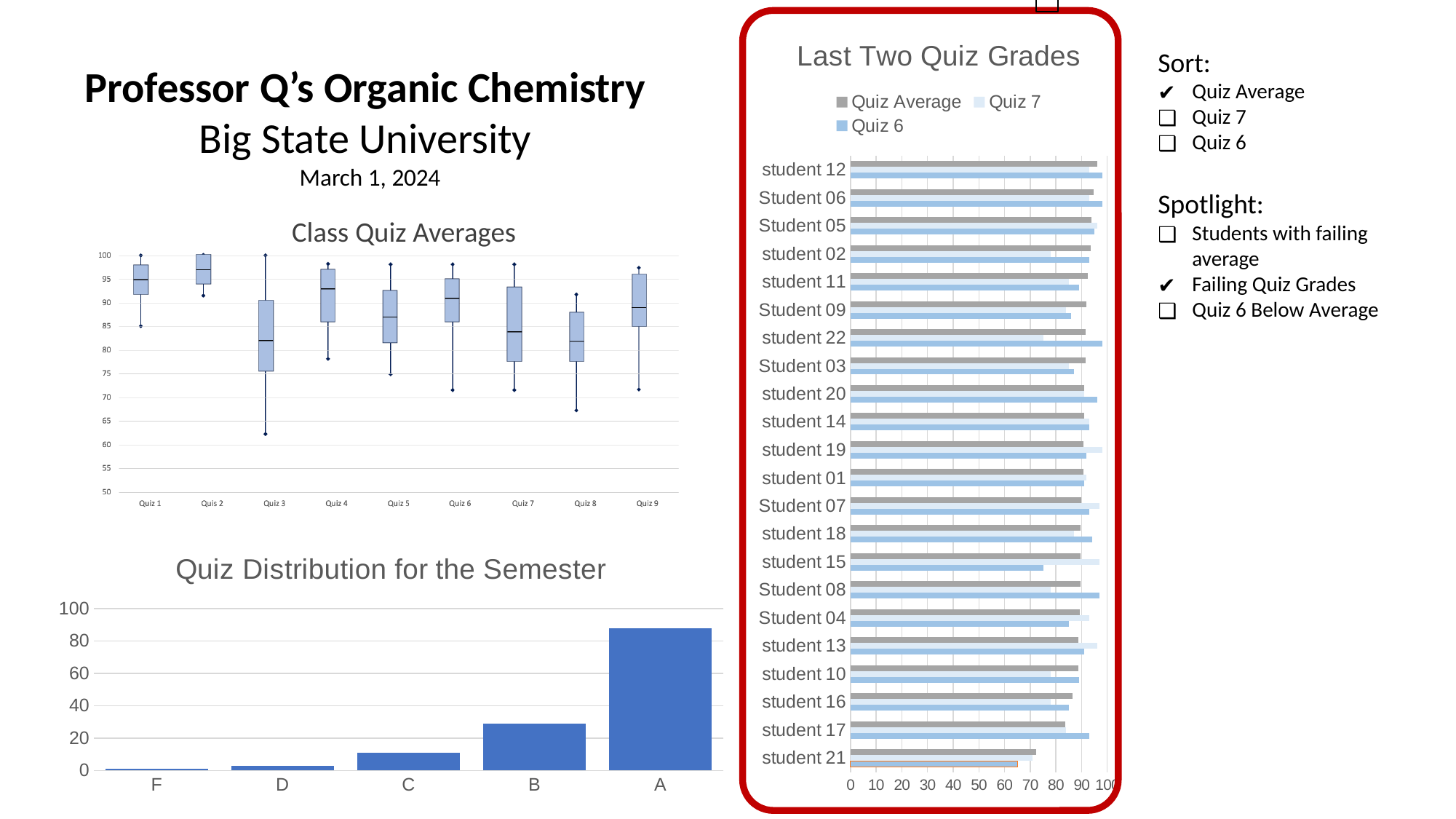
In "Quiz Distribution for the Semester", is the value for C greater or less than 20? less In "Quiz Distribution for the Semester", which grade category has the lowest value? F In "Quiz Distribution for the Semester", which grade category has the highest value? A In "Quiz Distribution for the Semester", do the values rise or fall moving from F to A along the x axis? rise In "Class Quiz Averages", how many quizzes are shown on the x axis? 9 In "Last Two Quiz Grades", how many series does the legend list? 3 In "Quiz Distribution for the Semester", is the value for A greater or less than 80? greater In "Last Two Quiz Grades", which student has the lowest Quiz Average? student 21 In "Quiz Distribution for the Semester", how many grade categories are shown on the x axis? 5 What kind of chart is "Quiz Distribution for the Semester"? bar chart